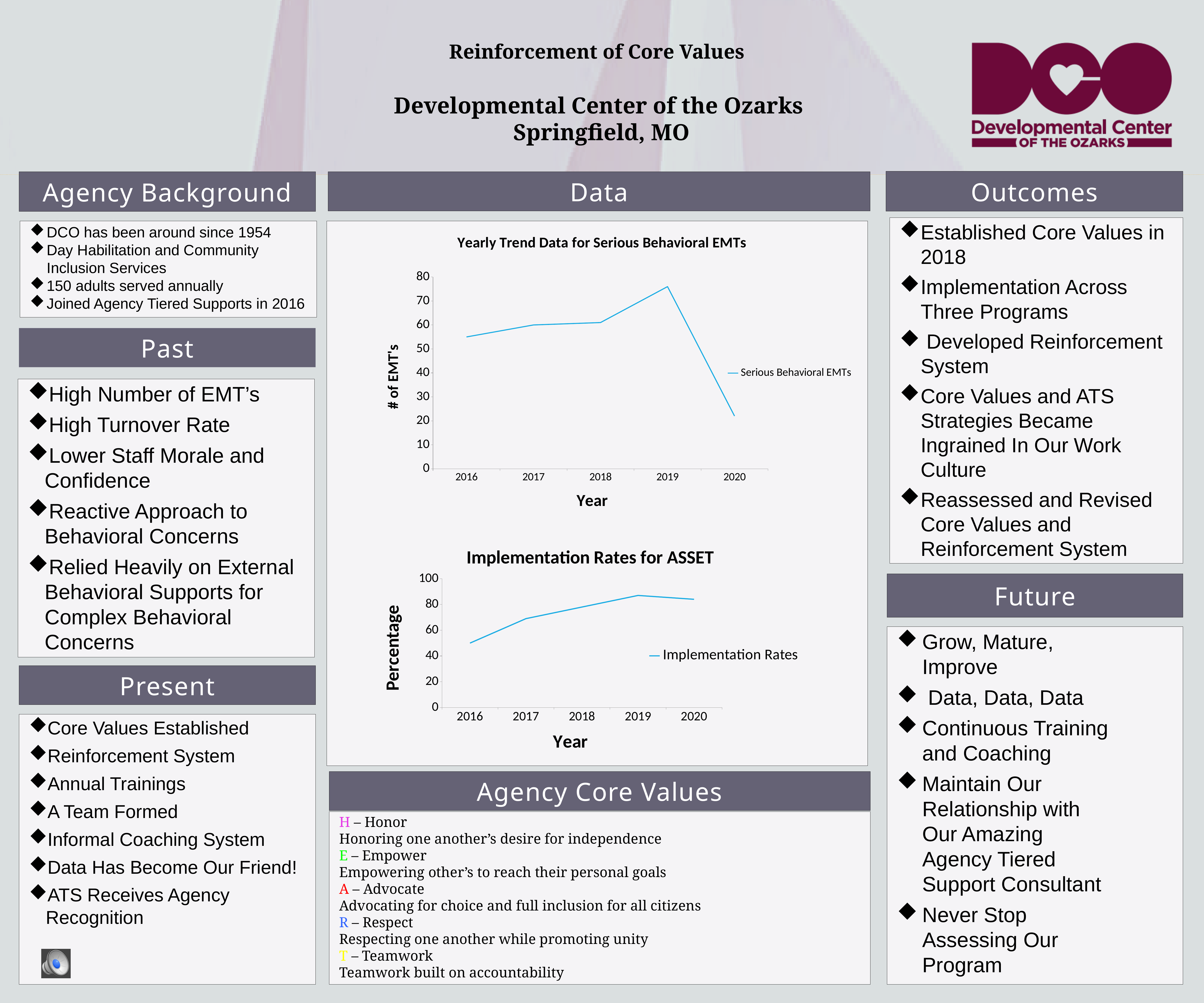
In the 'Yearly Trend Data for Serious Behavioral EMTs' chart, is the value for 2020 greater or less than 30? less In the 'Yearly Trend Data for Serious Behavioral EMTs' chart, which year has the lowest number of EMTs? 2020 In the 'Yearly Trend Data for Serious Behavioral EMTs' chart, which year has the highest number of EMTs? 2019 What type of chart is 'Implementation Rates for ASSET'? line chart How many series does the legend of the 'Implementation Rates for ASSET' chart list? 1 In the 'Yearly Trend Data for Serious Behavioral EMTs' chart, is the value for 2019 greater or less than 70? greater How many years are plotted in the 'Yearly Trend Data for Serious Behavioral EMTs' chart? 5 In the 'Implementation Rates for ASSET' chart, is the value for 2019 greater or less than 80? greater In the 'Yearly Trend Data for Serious Behavioral EMTs' chart, which is larger, the value for 2018 or the value for 2020? 2018 In the 'Implementation Rates for ASSET' chart, which year has the lowest implementation rate? 2016